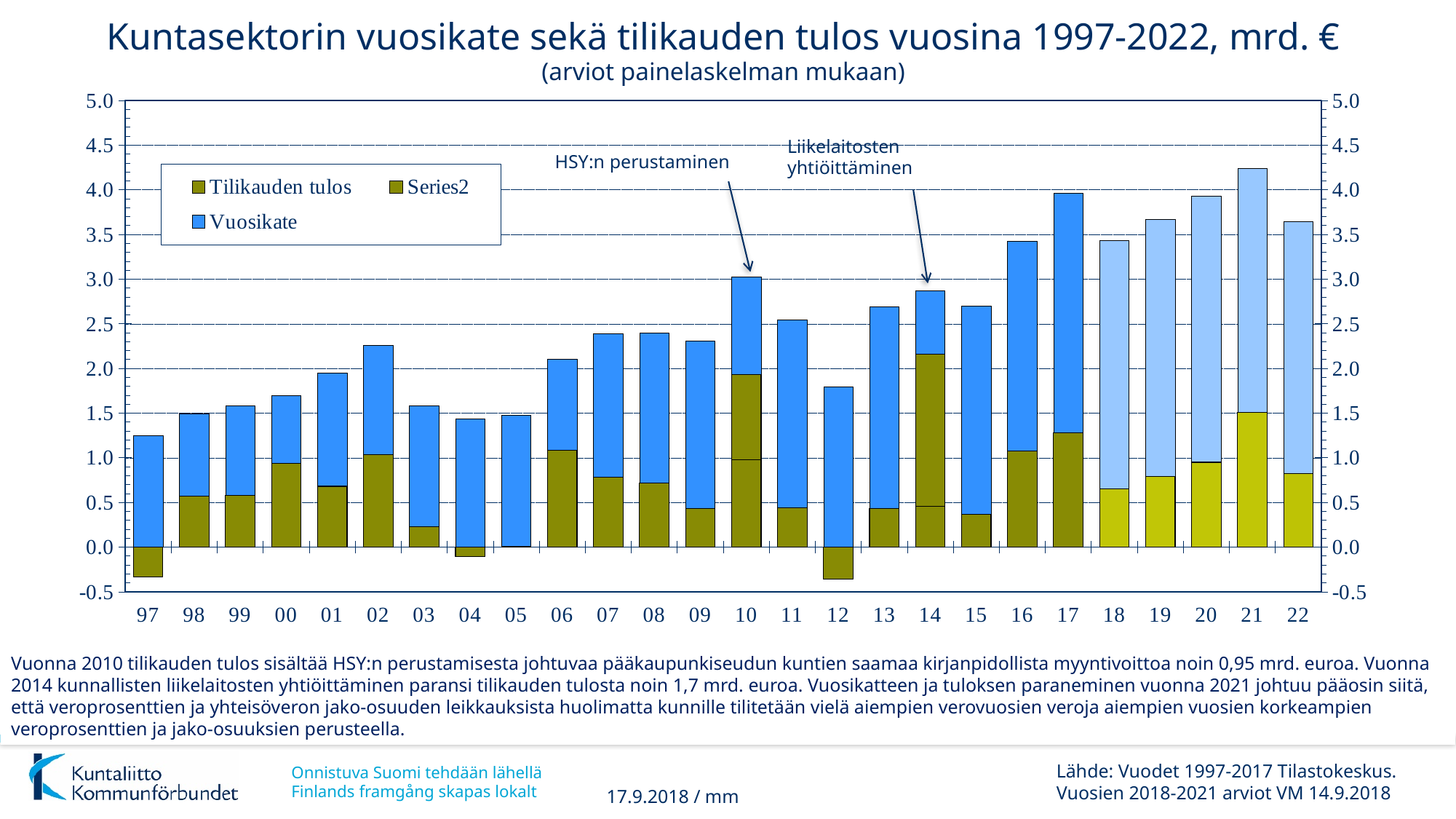
Is the Tilikauden tulos value for 14 greater or less than 2.0? greater How many series does the chart legend list? 3 Which year does the annotation 'HSY:n perustaminen' point to? 10 Which year has the larger Vuosikate, 17 or 18? 17 What kind of chart is shown on the slide? bar chart In which year is Vuosikate lowest? 97 Is the Vuosikate value for 17 greater or less than 3.5? greater In which year is Vuosikate highest? 21 In which year is Tilikauden tulos highest? 14 Which year has the larger Tilikauden tulos, 10 or 14? 14 How many years are shown on the x axis of the chart? 26 Is the Vuosikate value for 12 greater or less than 2.0? less